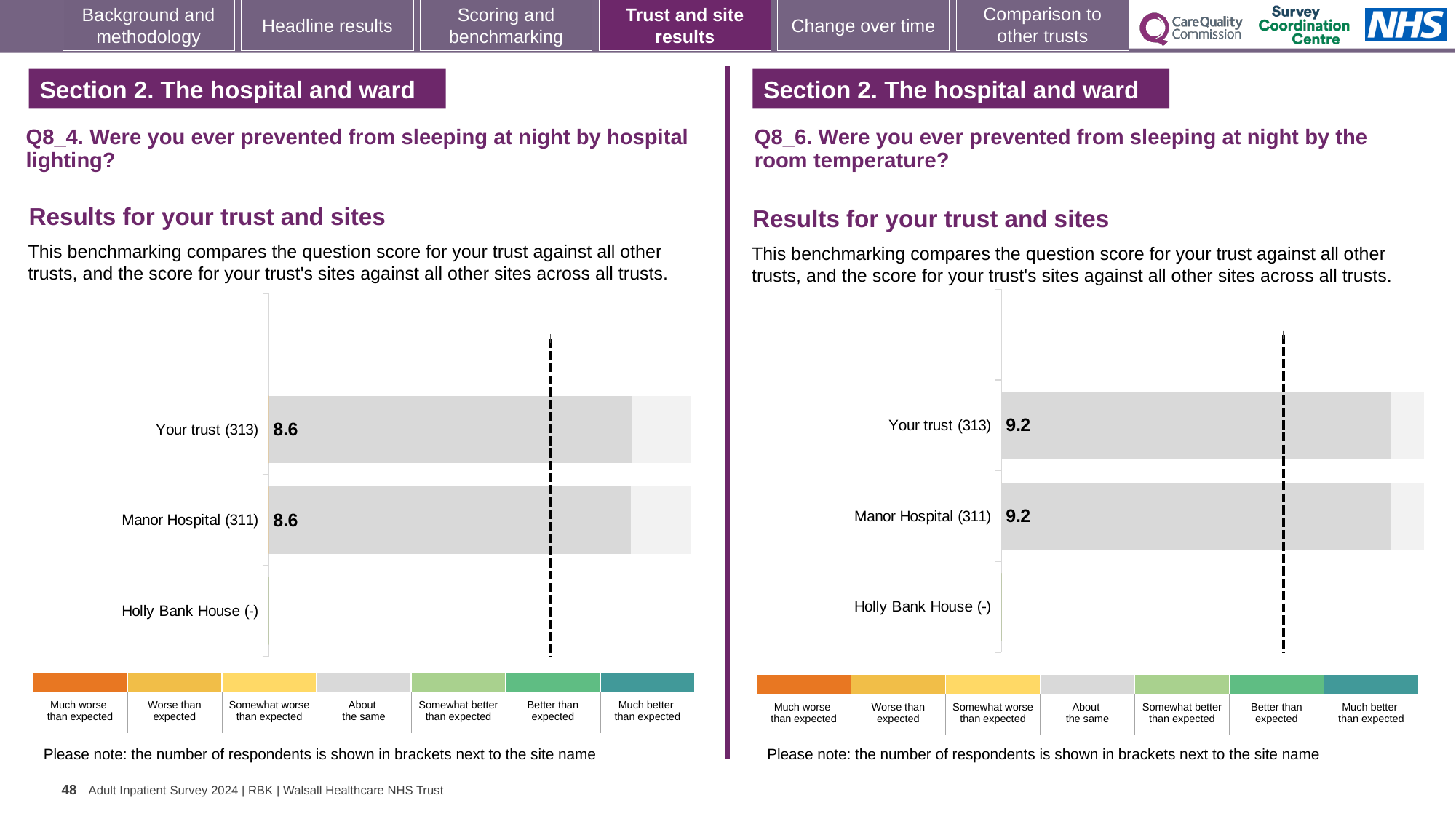
In the Q8_4 hospital lighting chart, what is the score for Manor Hospital (311)? 8.6 In the Q8_6 room temperature chart, which category has no bar plotted? Holly Bank House (-) What is the difference between the Your trust (313) score in the Q8_6 room temperature chart and the Your trust (313) score in the Q8_4 hospital lighting chart? 0.6 In the Q8_6 room temperature chart, what is the score for Manor Hospital (311)? 9.2 Which is larger: the Your trust (313) score in the Q8_4 hospital lighting chart or the Your trust (313) score in the Q8_6 room temperature chart? Q8_6 room temperature (9.2) In the Q8_4 hospital lighting chart, how many site/trust categories are listed on the vertical axis? 3 How many respondents are shown in brackets for Manor Hospital in the Q8_4 hospital lighting chart? 311 In the Q8_6 room temperature chart, how many site/trust categories are listed on the vertical axis? 3 In the Q8_6 room temperature chart, what is the score for Your trust (313)? 9.2 In the Q8_4 hospital lighting chart, what is the difference between the Your trust (313) score and the Manor Hospital (311) score? 0 What kind of chart is used in the Q8_4 hospital lighting chart? Bar chart In the Q8_4 hospital lighting chart, what is the score for Your trust (313)? 8.6